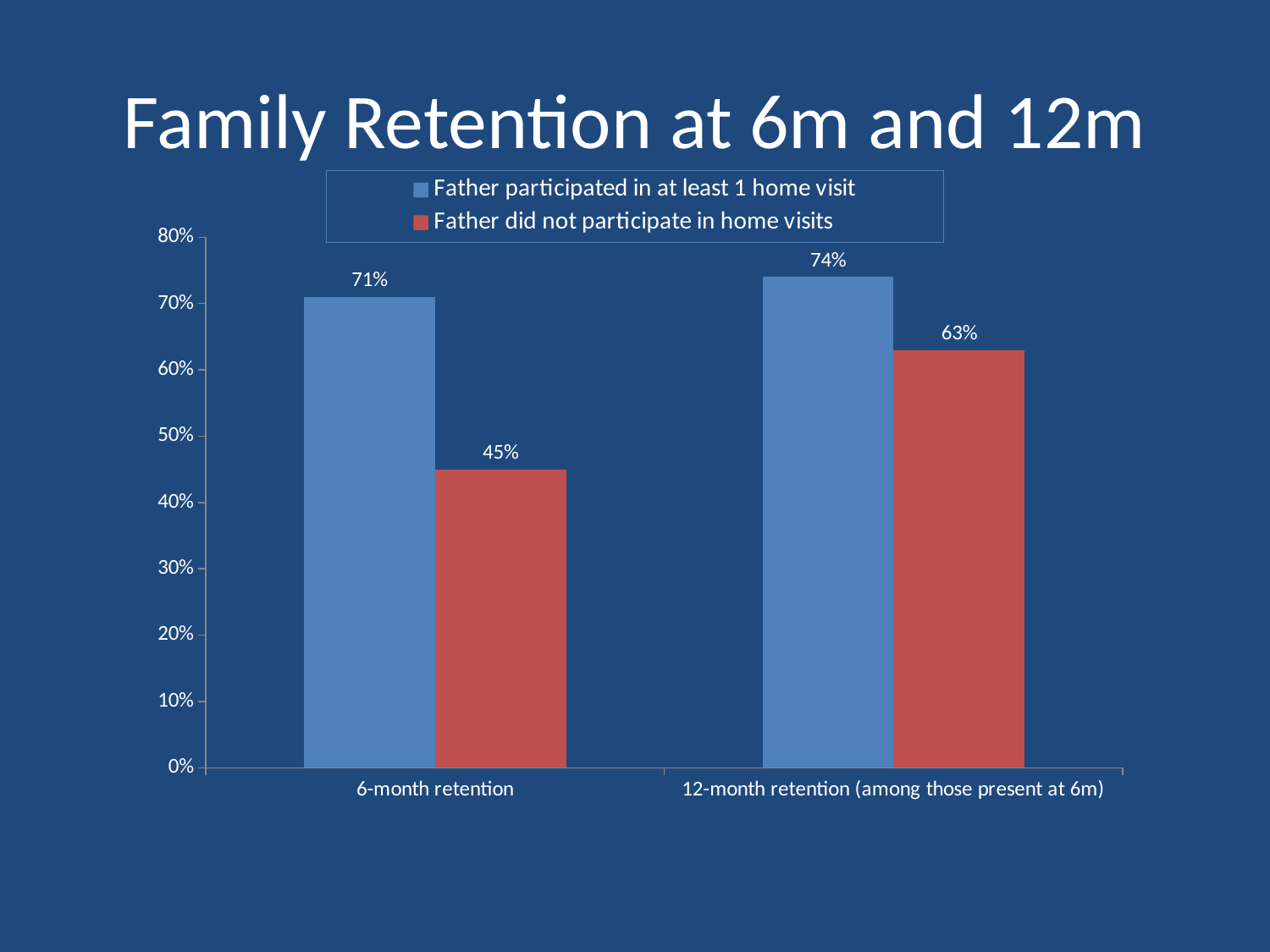
Which bar shows the highest value on the chart? Father participated in at least 1 home visit, 12-month retention (74%) What is the 6-month retention for families where the father did not participate in home visits? 45% For the 'Father did not participate in home visits' series, is retention higher at 6 months or at 12 months? 12 months What is the difference in 6-month retention between families where the father participated in at least 1 home visit and those where he did not? 26 percentage points What is the difference in 12-month retention between families where the father participated in at least 1 home visit and those where he did not? 11 percentage points What is the 12-month retention (among those present at 6m) for families where the father did not participate in home visits? 63% What type of chart is shown on the slide? Bar chart What is the 6-month retention for families where the father participated in at least 1 home visit? 71% How many categories are shown on the x axis? 2 How many series does the legend list? 2 What is the 12-month retention (among those present at 6m) for families where the father participated in at least 1 home visit? 74% Which bar shows the lowest value on the chart? Father did not participate in home visits, 6-month retention (45%)